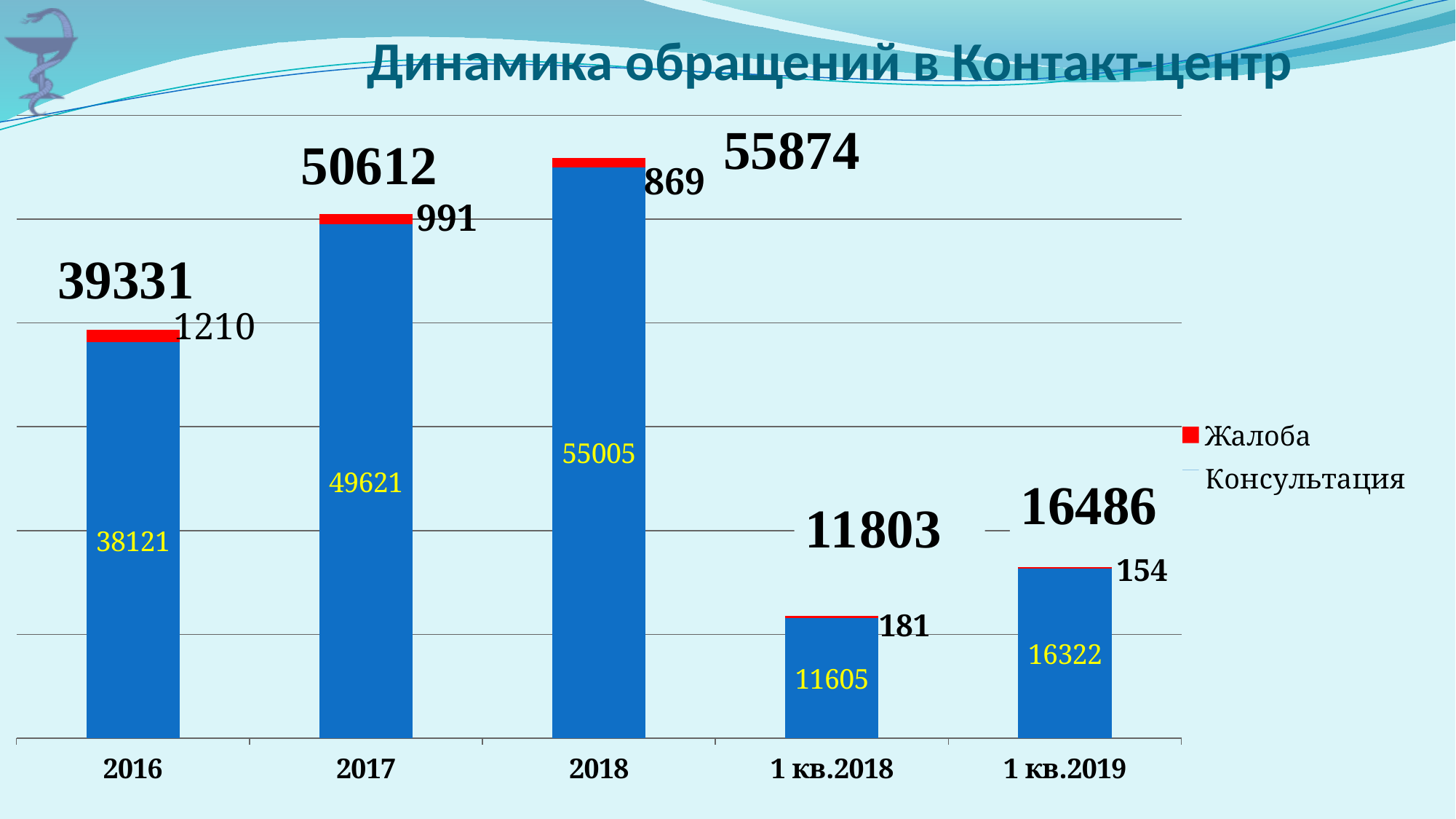
What type of chart is shown on the slide? Stacked bar chart What is the difference between the Консультация values for 1 кв.2019 and 1 кв.2018? 4717 What is the value of Жалоба for 2016? 1210 What is the value of Консультация for 2017? 49621 How many series does the legend list? 2 Do the Жалоба values rise or fall from 2016 to 2018? Fall Which category has the lowest total? 1 кв.2018 What is the value of Жалоба for 1 кв.2019? 154 Which is larger, the Жалоба value for 2017 or for 2018? 2017 What is the total of the stacked bar for 2018? 55874 How many categories are shown on the x axis? 5 Which category has the highest total? 2018